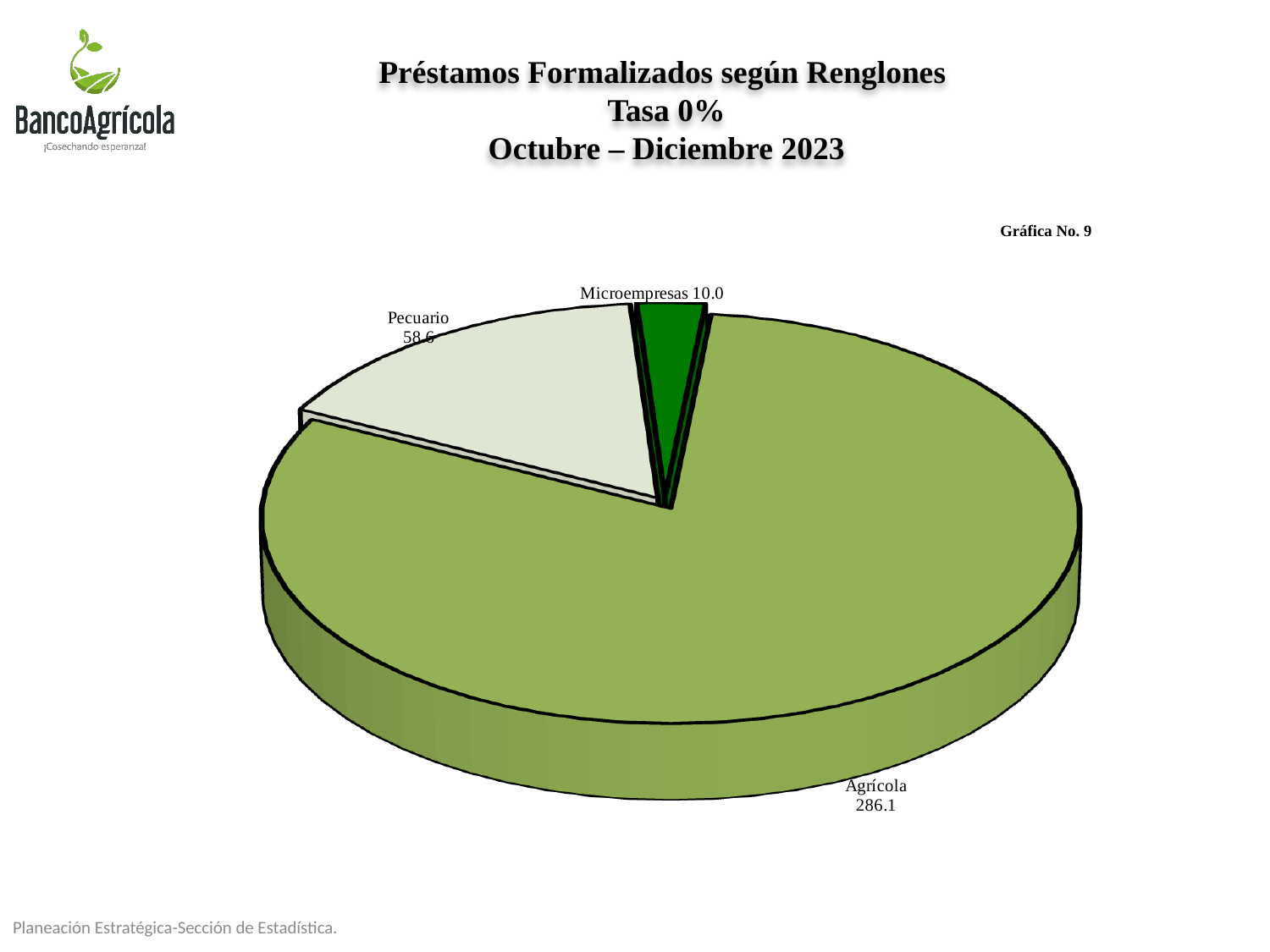
What is the title of the chart on the slide? Préstamos Formalizados según Renglones Tasa 0% Octubre – Diciembre 2023 Which is larger, the slice for Pecuario or the slice for Microempresas? Pecuario What is the value shown for Microempresas? 10.0 What is the difference between the values for Agrícola and Microempresas? 276.1 What graph number is given on the slide? Gráfica No. 9 How many slices does the pie chart have? 3 What is the value shown for Agrícola? 286.1 Which category has the largest slice of the pie? Agrícola Which is larger, the slice for Agrícola or the slice for Pecuario? Agrícola Which category has the smallest slice of the pie? Microempresas What kind of chart is shown on the slide? pie chart